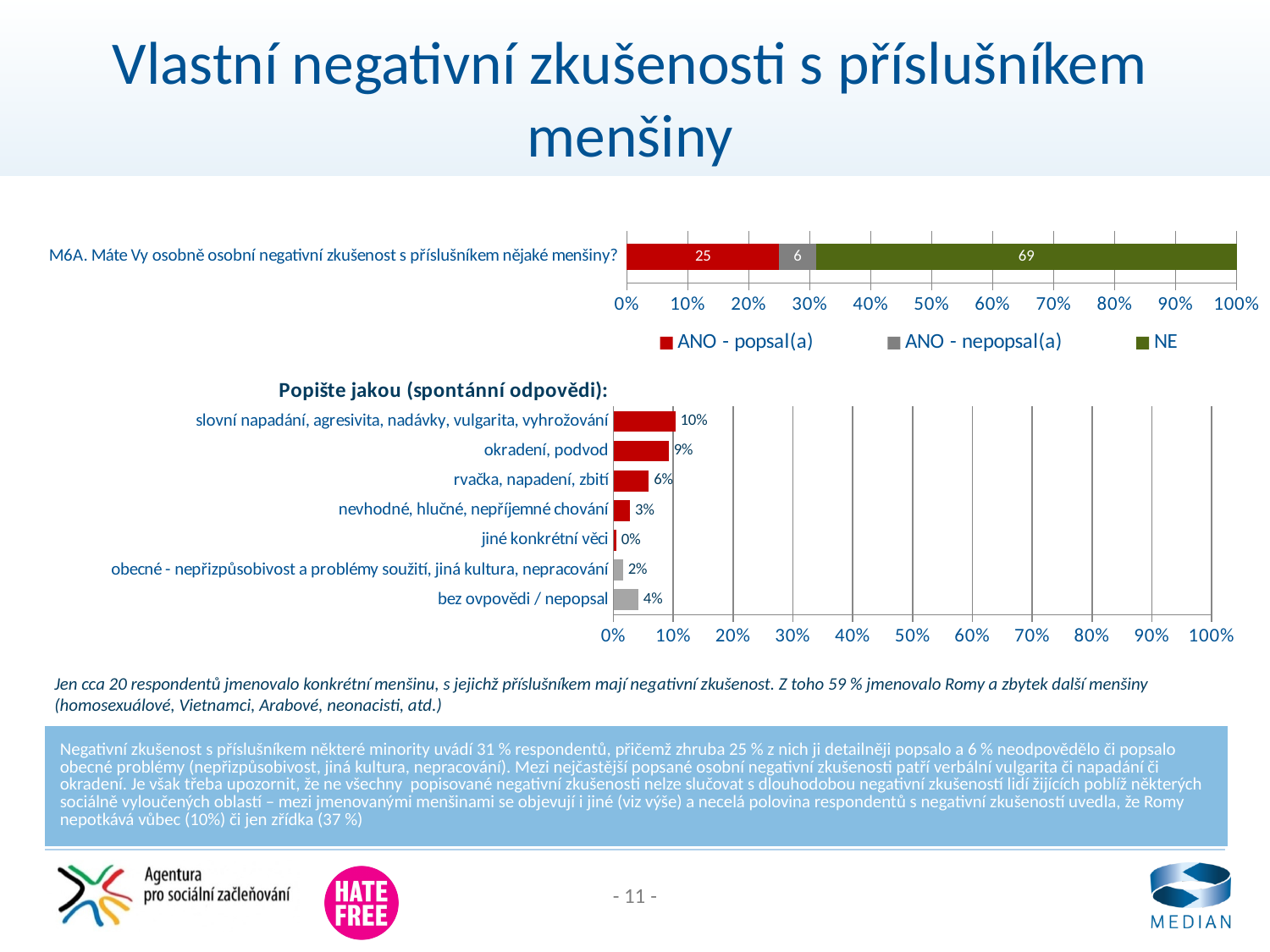
In the bottom chart 'Popište jakou (spontánní odpovědi)', what is the value for 'bez ovpovědi / nepopsal'? 4% In the top chart (M6A), what is the total of the stacked bar? 100 In the top chart (M6A), which series has the largest segment? NE In the top chart (M6A), what is the value for 'ANO - popsal(a)'? 25 In the top chart (M6A), what is the value for 'NE'? 69 In the bottom chart 'Popište jakou (spontánní odpovědi)', which category has the highest value? slovní napadání, agresivita, nadávky, vulgarita, vyhrožování How many series does the legend of the top chart (M6A) list? 3 In the bottom chart 'Popište jakou (spontánní odpovědi)', what is the value for 'okradení, podvod'? 9% In the top chart (M6A), what is the value for 'ANO - nepopsal(a)'? 6 In the bottom chart 'Popište jakou (spontánní odpovědi)', what is the difference between 'slovní napadání, agresivita, nadávky, vulgarita, vyhrožování' and 'rvačka, napadení, zbití'? 4% In the bottom chart 'Popište jakou (spontánní odpovědi)', which category has the lowest value? jiné konkrétní věci How many categories are shown in the bottom chart 'Popište jakou (spontánní odpovědi)'? 7